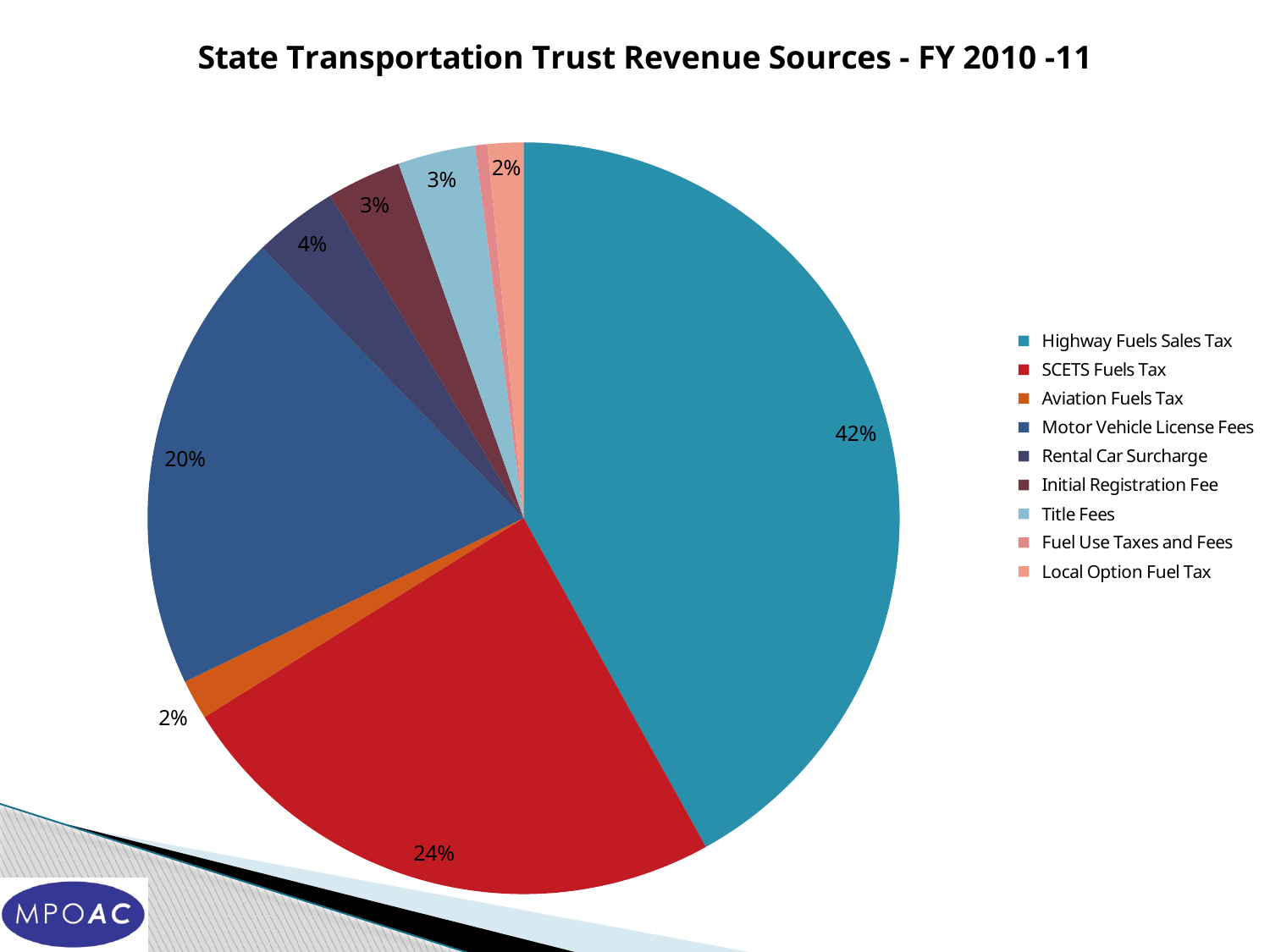
What percentage is shown for the Rental Car Surcharge slice? 4% Which revenue source has the largest slice of the pie? Highway Fuels Sales Tax What share of the pie is Aviation Fuels Tax? 2% How many percentage points larger is the Highway Fuels Sales Tax share than the SCETS Fuels Tax share? 18 percentage points What share is labelled for Motor Vehicle License Fees? 20% How many revenue sources does the legend list? 9 What is the title of the chart? State Transportation Trust Revenue Sources - FY 2010 -11 What is the combined share of Highway Fuels Sales Tax and SCETS Fuels Tax? 66% Which is larger, the SCETS Fuels Tax slice or the Motor Vehicle License Fees slice? SCETS Fuels Tax What type of chart is shown on the slide? Pie chart What percentage is shown for SCETS Fuels Tax? 24% What share of the pie does Highway Fuels Sales Tax represent? 42%